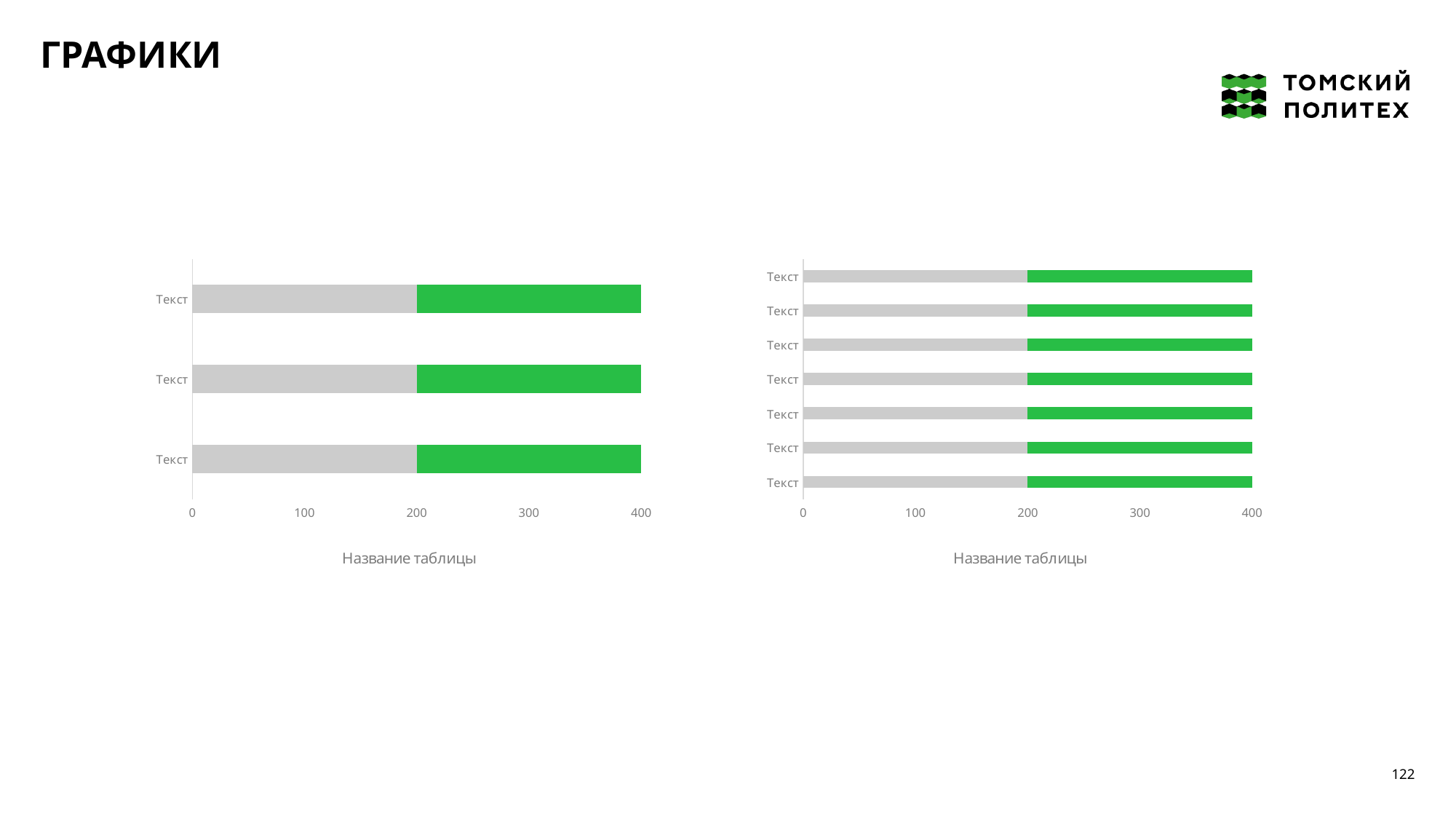
In the chart on the right of the slide, at what value does the green segment of each bar end? 400 In the chart on the left of the slide, what is the total length of each stacked bar? 400 In the chart on the right of the slide, is the grey segment of the bottom bar greater or less than 300? less What is the highest value shown on the x axis of the chart on the right of the slide? 400 What kind of chart is the chart on the right of the slide? bar chart How many bars does the chart on the right of the slide have? 7 In the chart on the left of the slide, is the total of the top bar greater or less than 300? greater In the chart on the left of the slide, at what value does the grey segment of each bar end? 200 What kind of chart is the chart on the left of the slide? bar chart How many bars does the chart on the left of the slide have? 3 In the chart on the right of the slide, what is the total length of each stacked bar? 400 What is the title shown below the chart on the left of the slide? Название таблицы